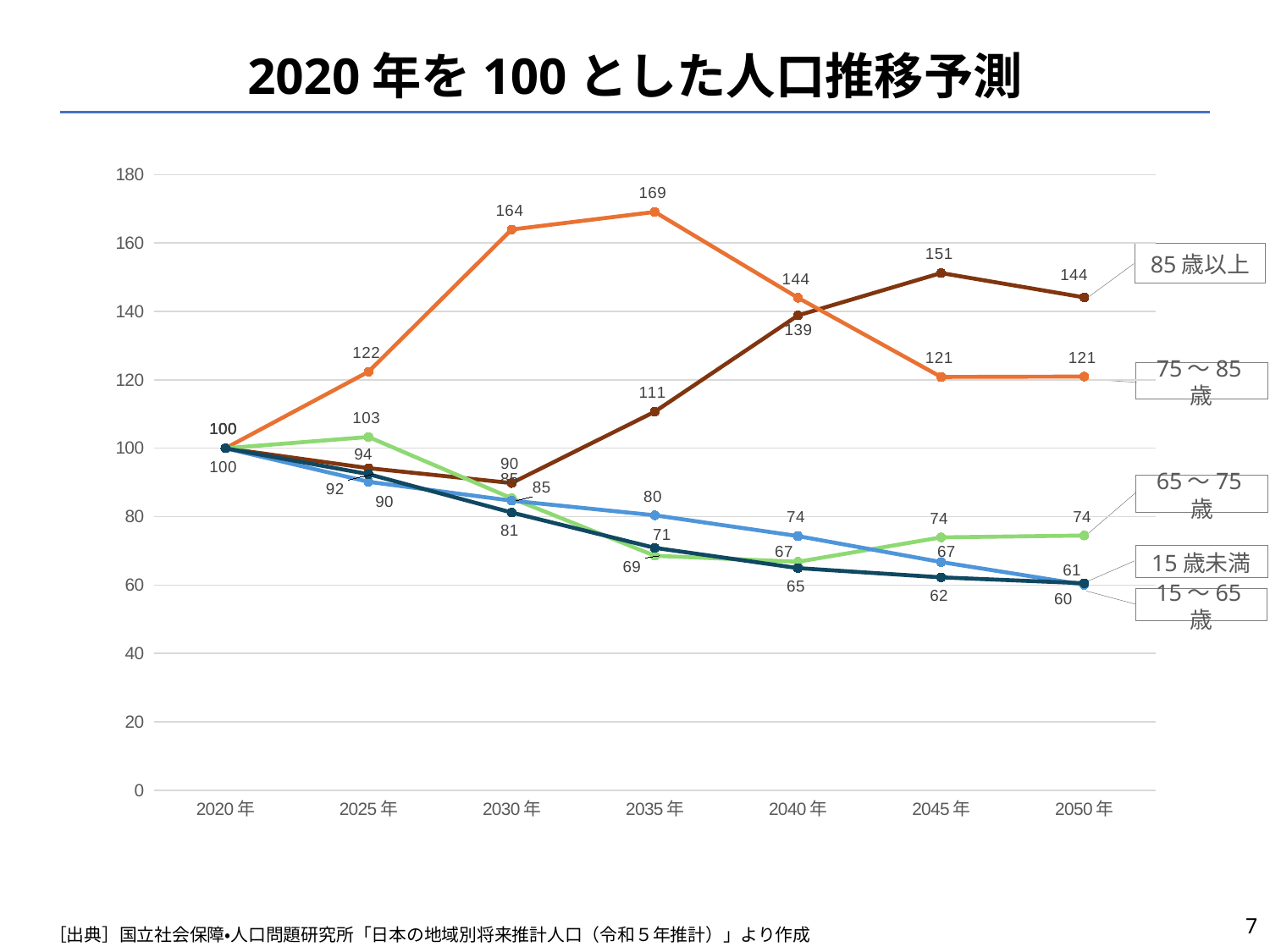
How many years are shown on the x axis? 7 What kind of chart is shown on the slide? Line chart Does the 15歳未満 series rise or fall from 2020年 to 2050年? Fall What is the value for 75～85歳 in 2035年? 169 What is the value for 15～65歳 in 2050年? 60 Which series has the lowest value in 2050年? 15～65歳 What is the value for 85歳以上 in 2045年? 151 In 2040年, which is larger: the value for 75～85歳 or the value for 85歳以上? 75～85歳 In which year does the 75～85歳 series reach its highest value? 2035年 What is the value for 65～75歳 in 2050年? 74 What is the difference between the 75～85歳 value in 2035年 and its value in 2050年? 48 How many series are plotted on the chart? 5